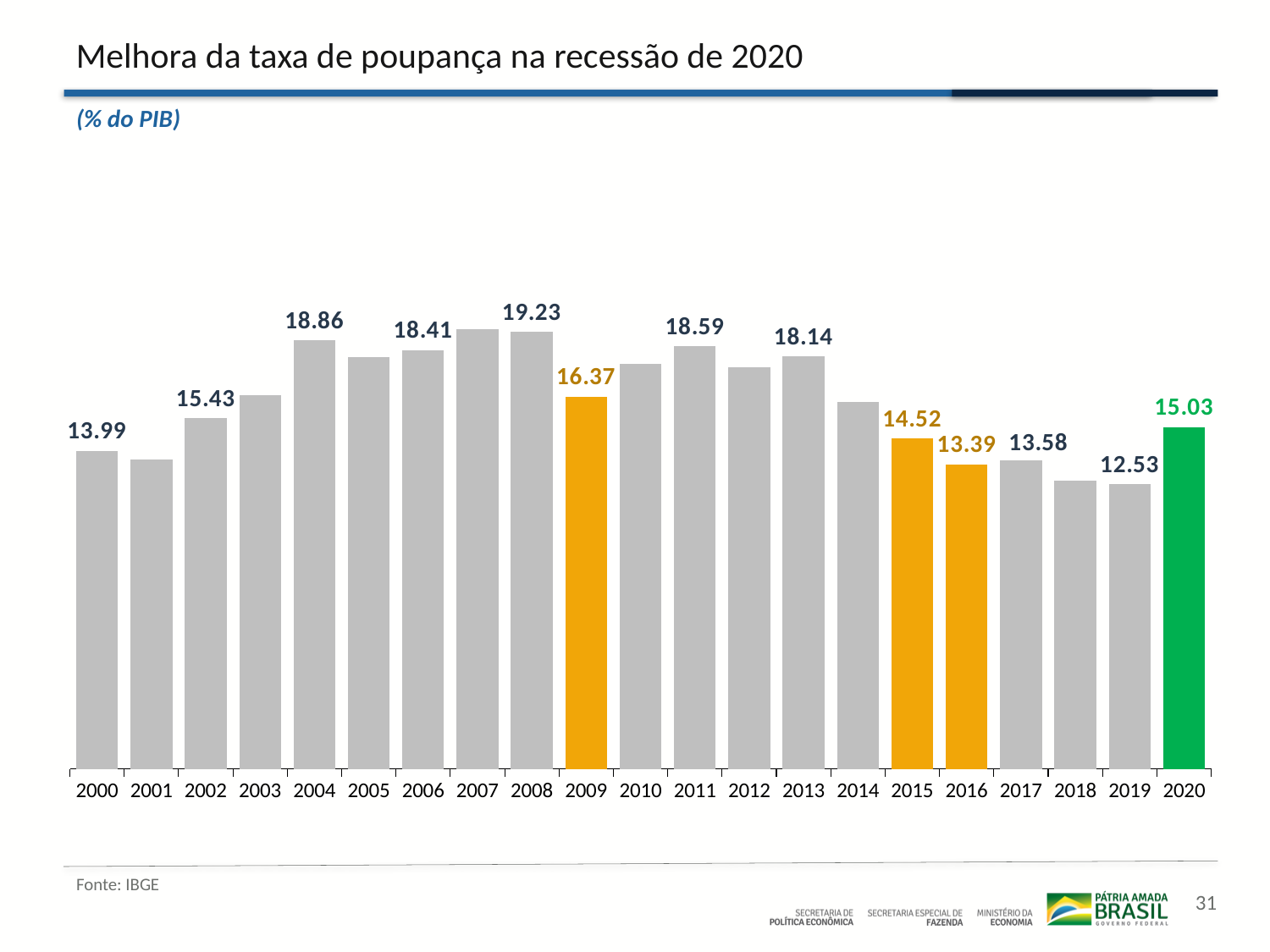
How many years are shown on the x axis? 21 What is the difference between the values for 2008 and 2009? 2.86 What is the difference between the values for 2020 and 2019? 2.50 What is the value for 2008? 19.23 What colour is the bar for 2020? green What is the value for 2016? 13.39 What is the value for 2020? 15.03 What kind of chart is shown on the slide? bar chart Which is larger, the value for 2019 or the value for 2020? 2020 Do the values rise or fall from 2013 to 2016? fall Which is larger, the value for 2004 or the value for 2006? 2004 What is the value for 2000? 13.99